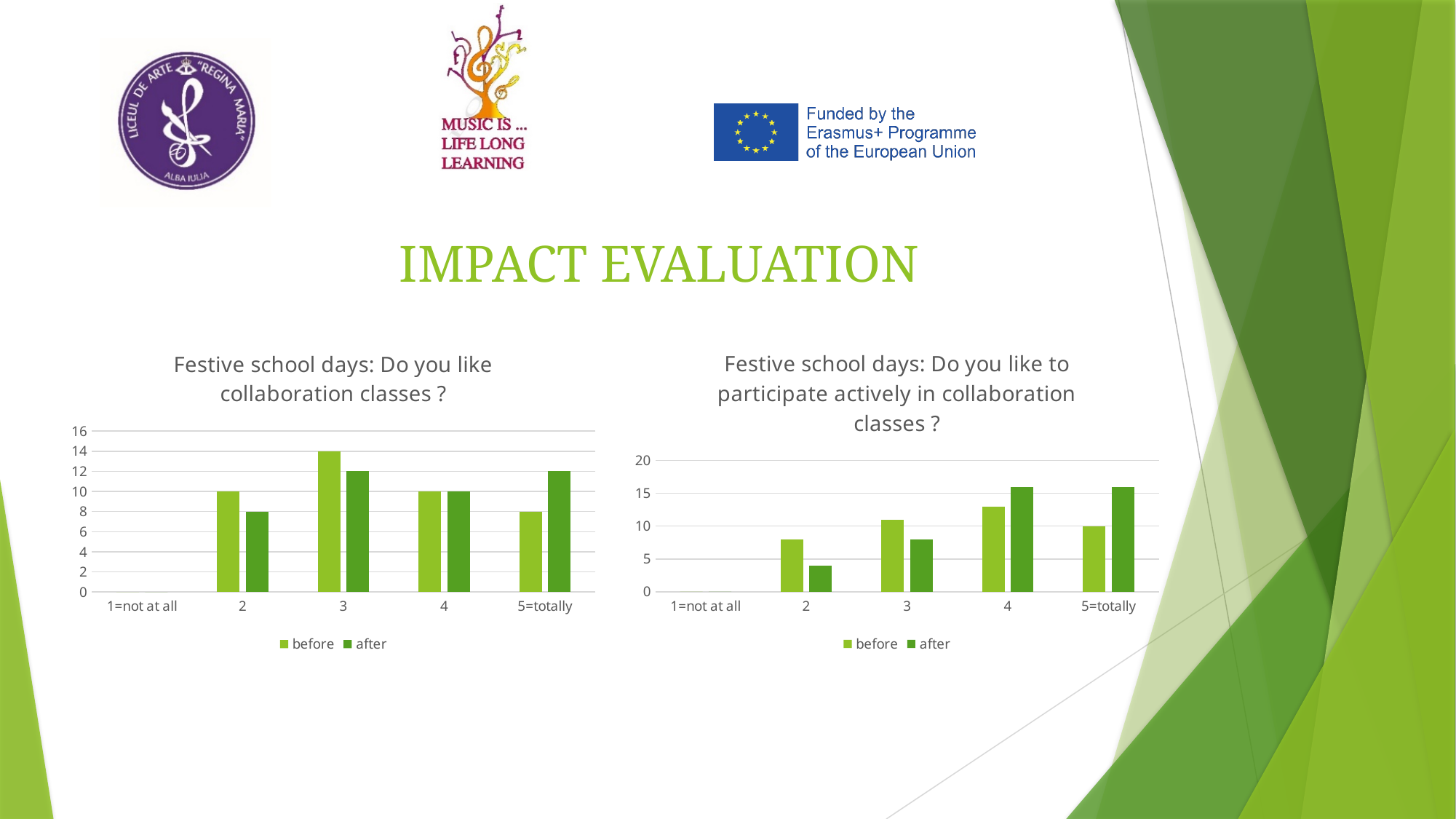
In the right chart ("Do you like to participate actively in collaboration classes ?"), is the "after" value at category 4 greater or less than 15? greater In the right chart ("Do you like to participate actively in collaboration classes ?"), is the "after" value at category 2 greater or less than 5? less In the left chart ("Do you like collaboration classes ?"), how many series does the legend list? 2 How many categories are shown on the x axis of the right chart ("Do you like to participate actively in collaboration classes ?")? 5 What type of chart is the left chart ("Do you like collaboration classes ?")? bar chart In the left chart ("Do you like collaboration classes ?"), what is the difference between the "before" and "after" values at category 5=totally? 4 In the left chart ("Do you like collaboration classes ?"), which category has the highest "before" value? 3 In the right chart ("Do you like to participate actively in collaboration classes ?"), which category has the lowest "after" value among categories 2 to 5=totally? 2 In the right chart ("Do you like to participate actively in collaboration classes ?"), which is larger at category 5=totally: the "before" value or the "after" value? after In the left chart ("Do you like collaboration classes ?"), which is larger at category 2: the "before" value or the "after" value? before In the left chart ("Do you like collaboration classes ?"), what is the value for "after" at category 5=totally? 12 In the left chart ("Do you like collaboration classes ?"), what is the value for "before" at category 3? 14